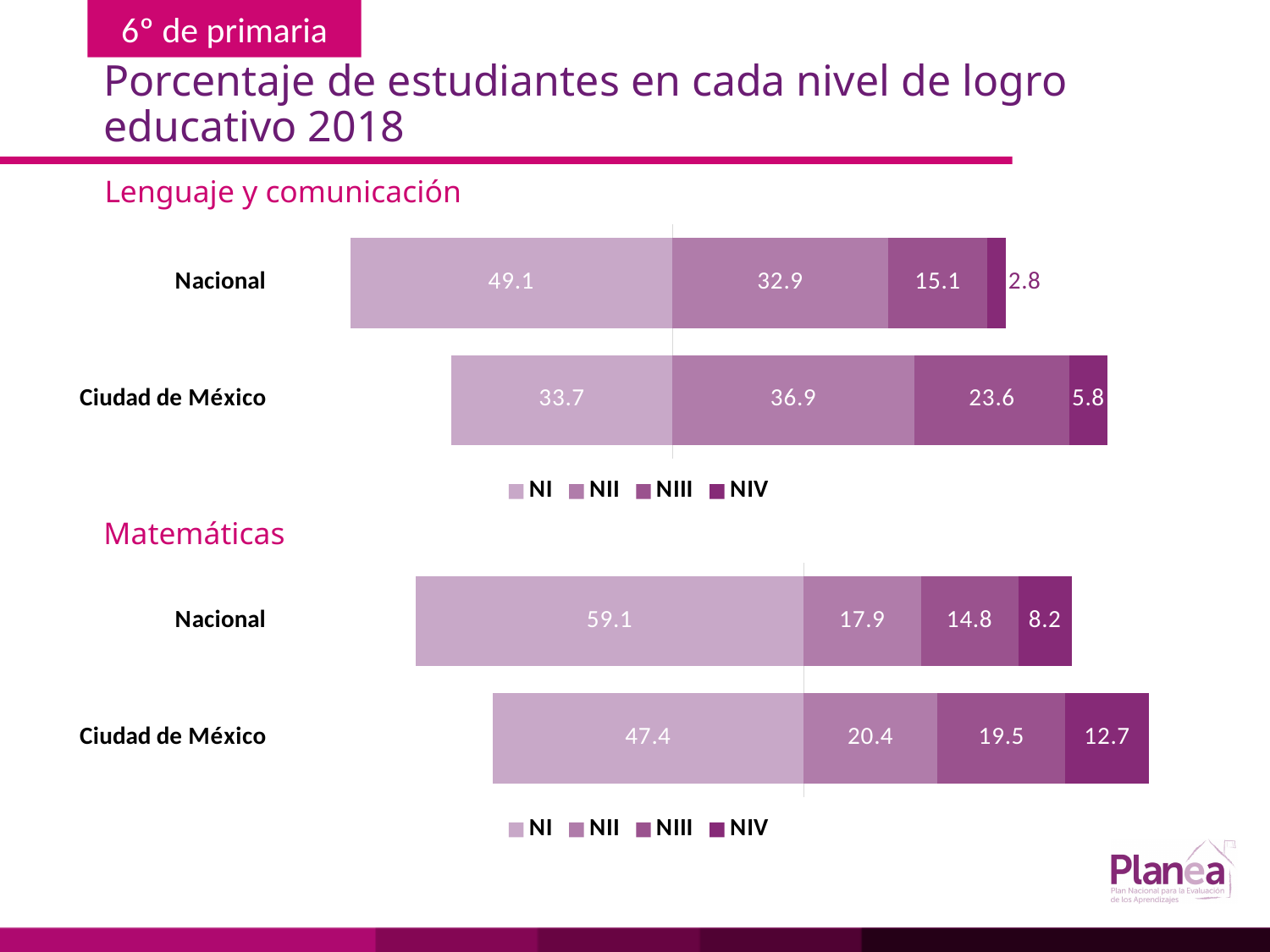
How many series does the legend of the Matemáticas chart list? 4 What kind of chart is the Matemáticas chart? Stacked bar chart In the Matemáticas chart, what is the NII value for Ciudad de México? 20.4 In the Lenguaje y comunicación chart, is the NIII value larger for Nacional or for Ciudad de México? Ciudad de México In the Matemáticas chart, which level has the lowest value for Nacional? NIV In the Lenguaje y comunicación chart, which level has the highest value for Ciudad de México? NII In the Matemáticas chart, what is the difference between the NI values for Nacional and Ciudad de México? 11.7 In the Matemáticas chart, what is the NIII value for Nacional? 14.8 In the Matemáticas chart, what is the total of the stacked bar for Ciudad de México? 100.0 In the Lenguaje y comunicación chart, what is the NIV value for Ciudad de México? 5.8 In the Lenguaje y comunicación chart, what is the NI value for Nacional? 49.1 How many categories are shown in the Lenguaje y comunicación chart? 2